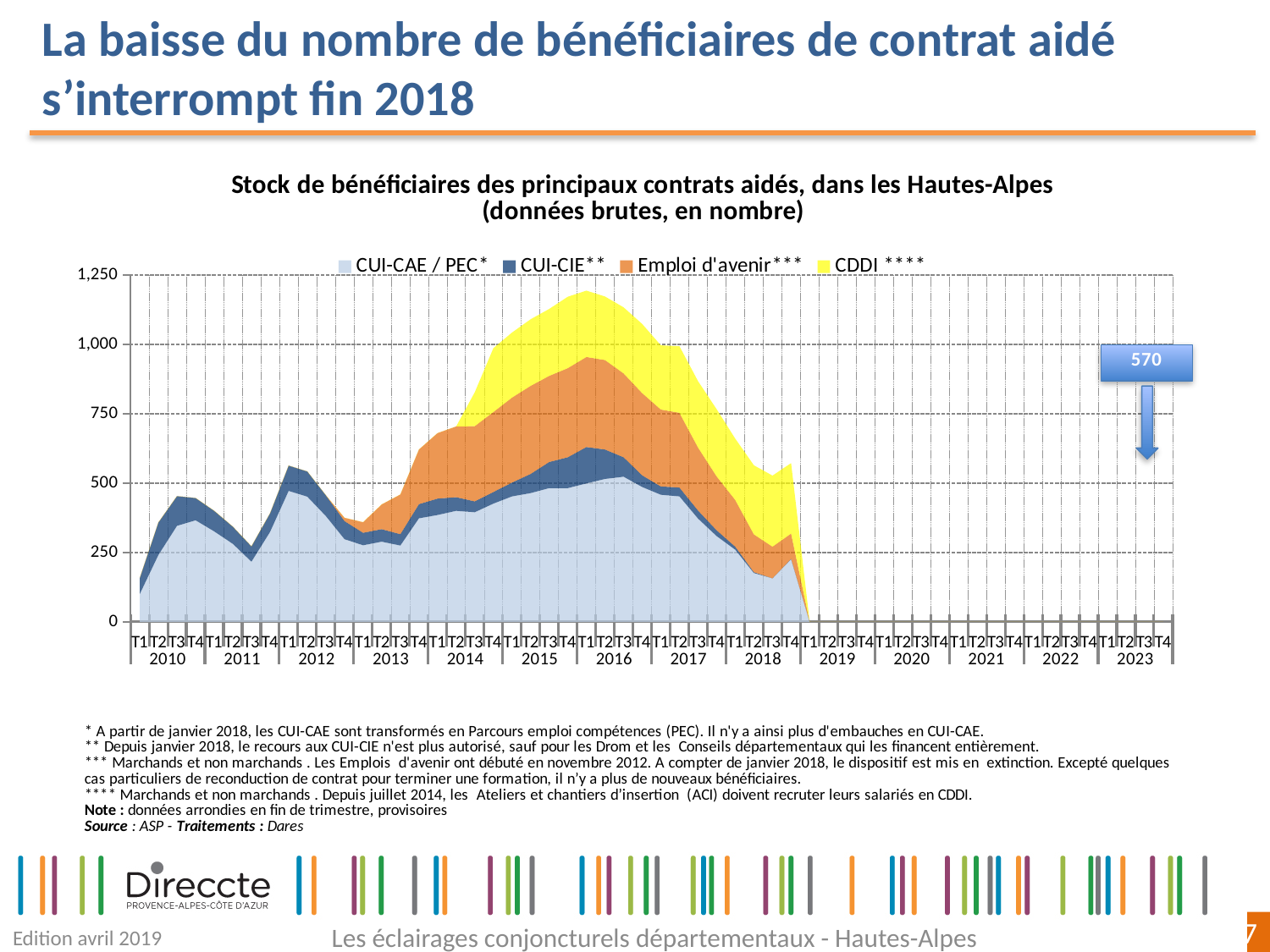
Does the total stacked value rise or fall between T1 2016 and T3 2018? fall Is the total stacked value at T2 2015 greater or less than 1,000? greater In which year does the total stacked value reach its highest peak? 2016 Which series is listed first in the legend? CUI-CAE / PEC* How many years are labelled along the x axis? 14 Is the total stacked value at T1 2010 greater or less than 250? less Does the total stacked value rise or fall between T1 2013 and T1 2016? rise Is the total stacked value at T1 2011 greater or less than 500? less How many series does the legend list? 4 Which series is plotted at the top of the stack (the yellow area)? CDDI **** What kind of chart is shown on the slide? stacked area chart